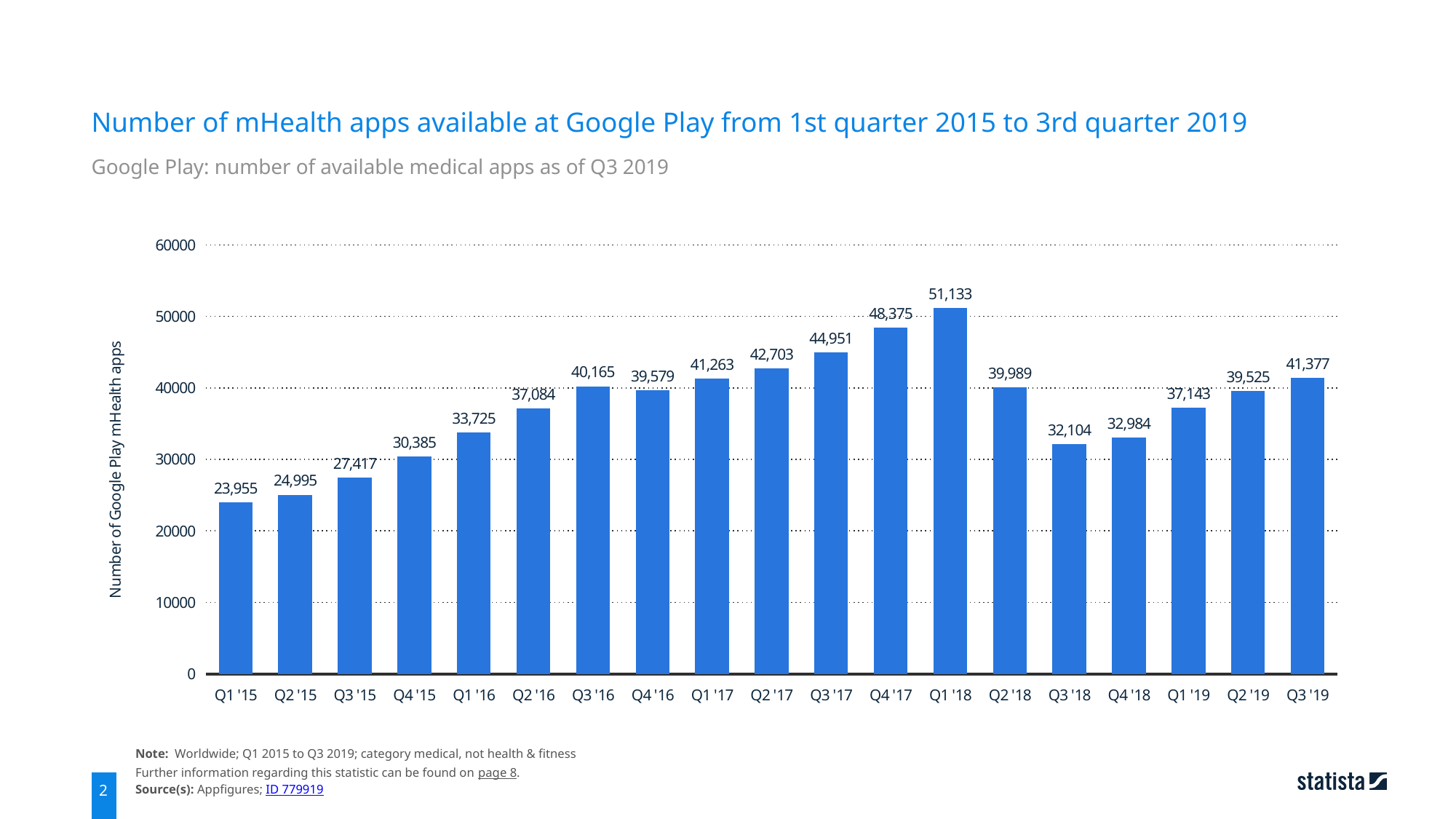
Which quarter has the highest number of mHealth apps? Q1 '18 What is the value shown for Q4 '15? 30,385 What is the difference between the values for Q1 '18 and Q2 '18? 11,144 Which is larger, the value for Q3 '16 or the value for Q4 '16? Q3 '16 Which quarter has the lowest number of mHealth apps? Q1 '15 Is the value for Q4 '17 greater or less than 50000? less What is the value shown for Q3 '19? 41,377 Do the values rise or fall from Q1 '15 to Q1 '18? Rise How many mHealth apps were available at Google Play in Q1 '18? 51,133 How many quarters are shown on the x axis? 19 What is the difference between the values for Q3 '19 and Q1 '15? 17,422 What kind of chart is shown on the slide? Bar chart